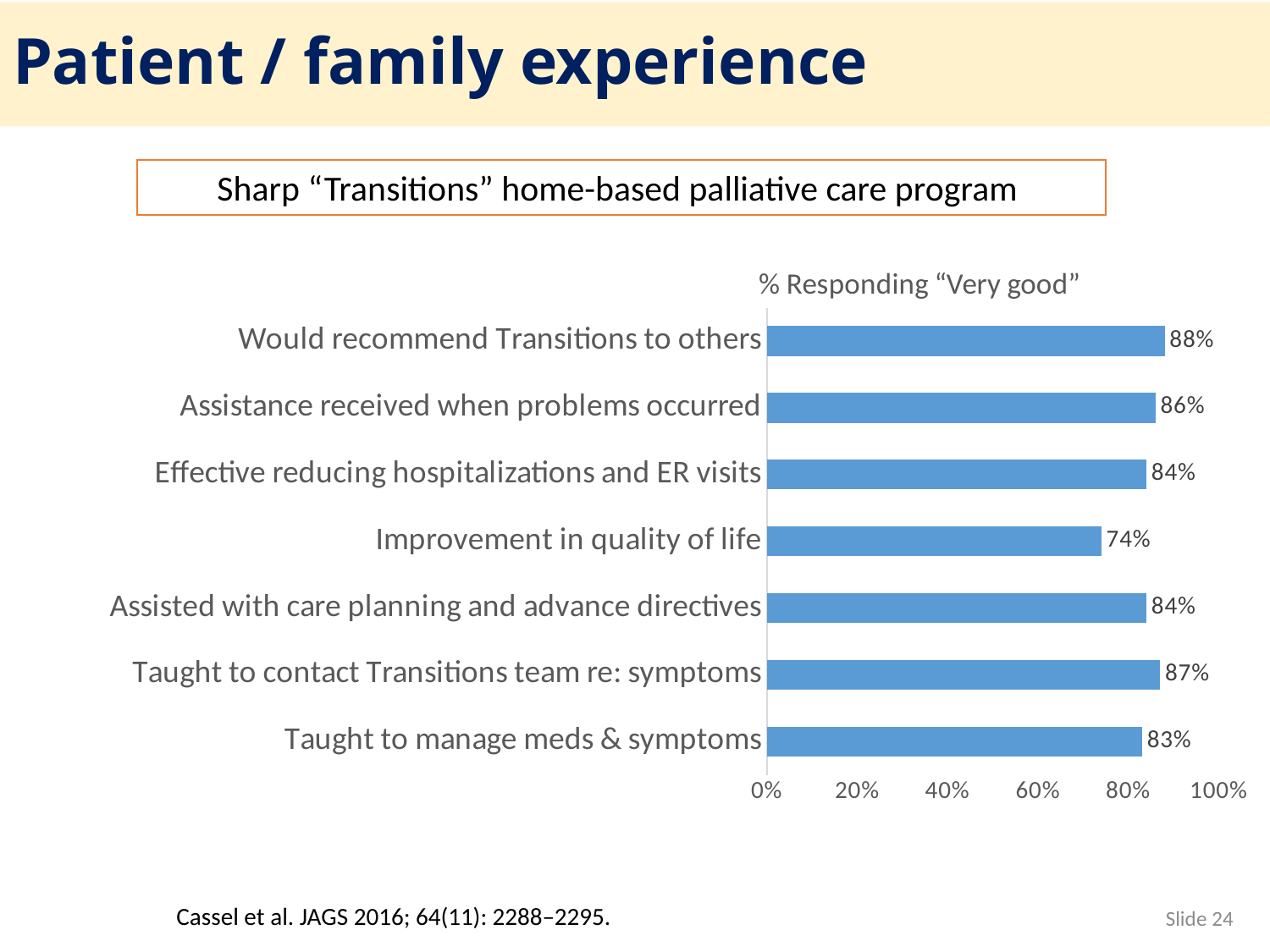
Which category has the lowest percentage responding "Very good"? Improvement in quality of life How many categories are shown in the chart? 7 Which category has the highest percentage responding "Very good"? Would recommend Transitions to others What percentage responded "Very good" for "Would recommend Transitions to others"? 88% What is the title of the chart? % Responding "Very good" What is the value for "Improvement in quality of life"? 74% What is the value for "Taught to contact Transitions team re: symptoms"? 87% Which is larger: "Assistance received when problems occurred" or "Taught to manage meds & symptoms"? Assistance received when problems occurred What is the value for "Taught to manage meds & symptoms"? 83% What is the difference between "Would recommend Transitions to others" and "Improvement in quality of life"? 14% Is the value for "Improvement in quality of life" greater or less than 80%? less What kind of chart is shown on the slide? bar chart